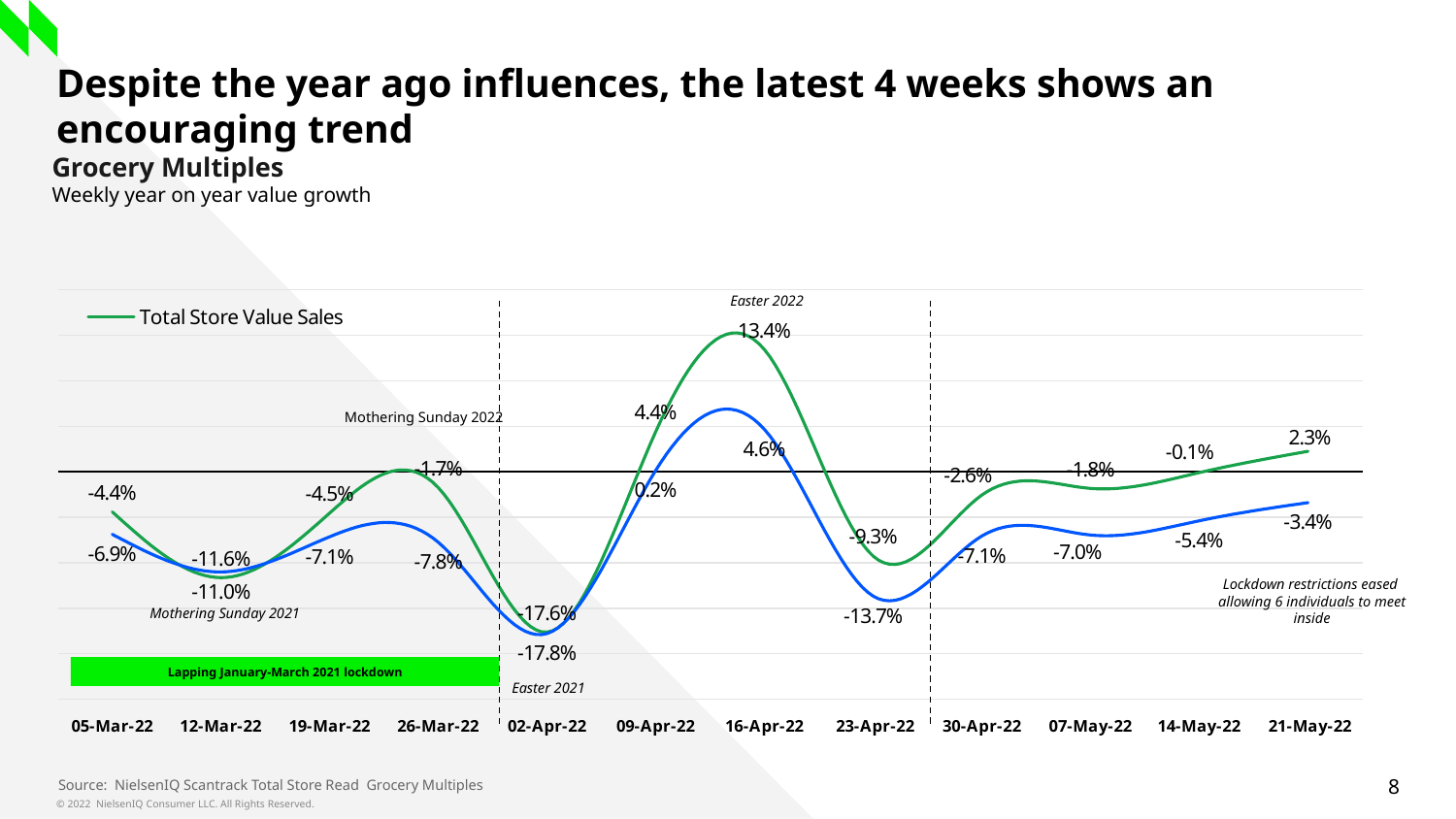
What is the difference between the Total Store Value Sales growth for 16-Apr-22 and 21-May-22? 11.1 percentage points What is the Total Store Value Sales growth for the week of 23-Apr-22? -9.3% Which week has the highest Total Store Value Sales growth? 16-Apr-22 What is the Total Store Value Sales growth for the week of 02-Apr-22? -17.6% What is the Total Store Value Sales growth for the week of 14-May-22? -0.1% What is the Total Store Value Sales growth for the week of 16-Apr-22? 13.4% How many weeks are shown on the x axis of the chart? 12 Does the Total Store Value Sales growth rise or fall from 23-Apr-22 to 21-May-22? Rise What is the Total Store Value Sales growth for the week of 21-May-22? 2.3% Which week has the lowest Total Store Value Sales growth? 02-Apr-22 Which week has the higher Total Store Value Sales growth, 09-Apr-22 or 21-May-22? 09-Apr-22 What type of chart is shown on the slide? Line chart